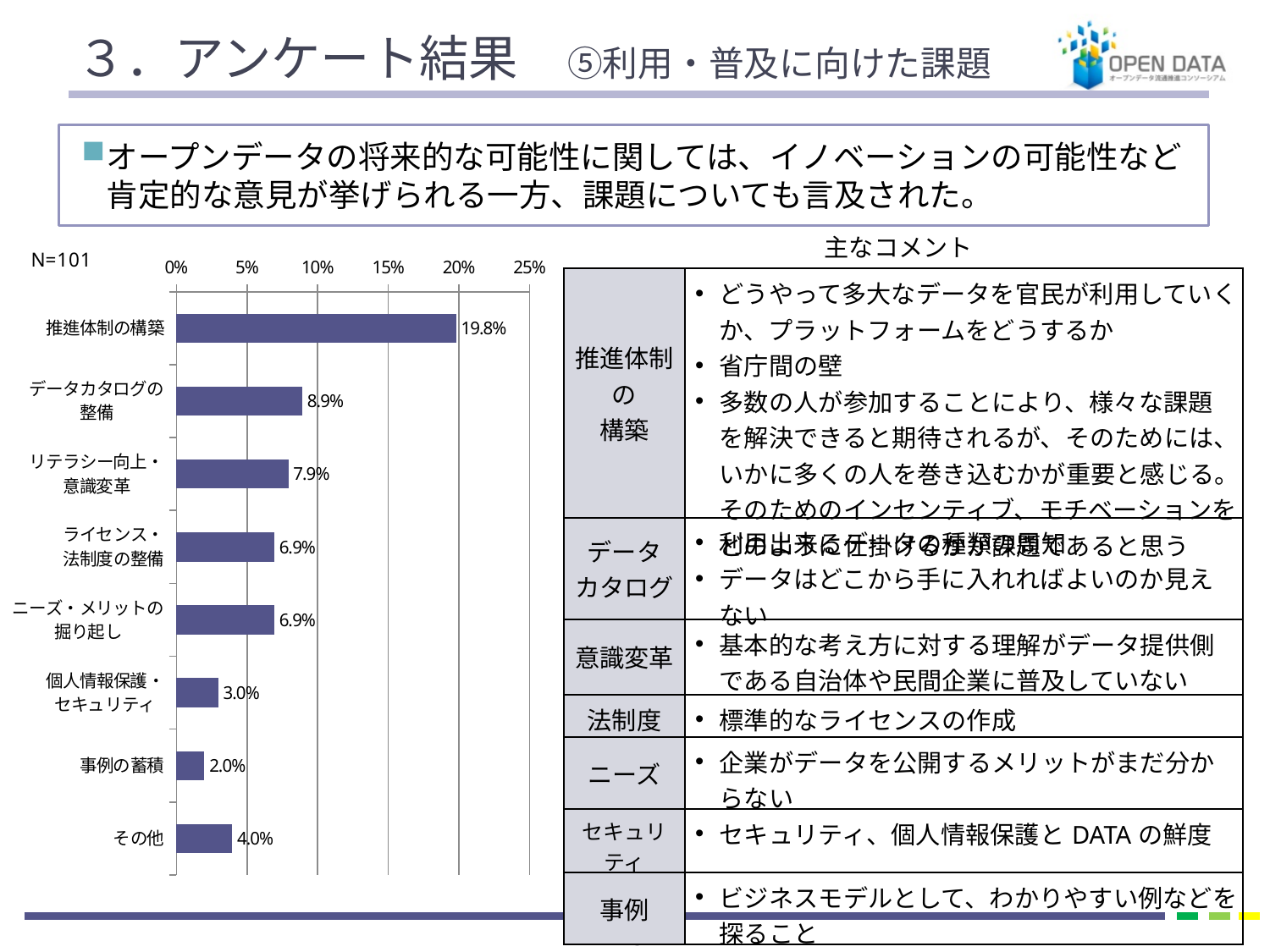
What is the sample size (N) shown next to the chart? N=101 What is the value for データカタログの整備? 8.9% What is the value for その他? 4.0% What is the value for 個人情報保護・セキュリティ? 3.0% Which category has the highest value? 推進体制の構築 What kind of chart is shown on the slide? bar chart Which is larger, the value for リテラシー向上・意識変革 or the value for その他? リテラシー向上・意識変革 Is the value for 推進体制の構築 greater or less than 15%? greater What is the difference between the values for 推進体制の構築 and データカタログの整備? 10.9% How many categories are shown in the bar chart? 8 What is the value for 推進体制の構築? 19.8% Which category has the lowest value? 事例の蓄積